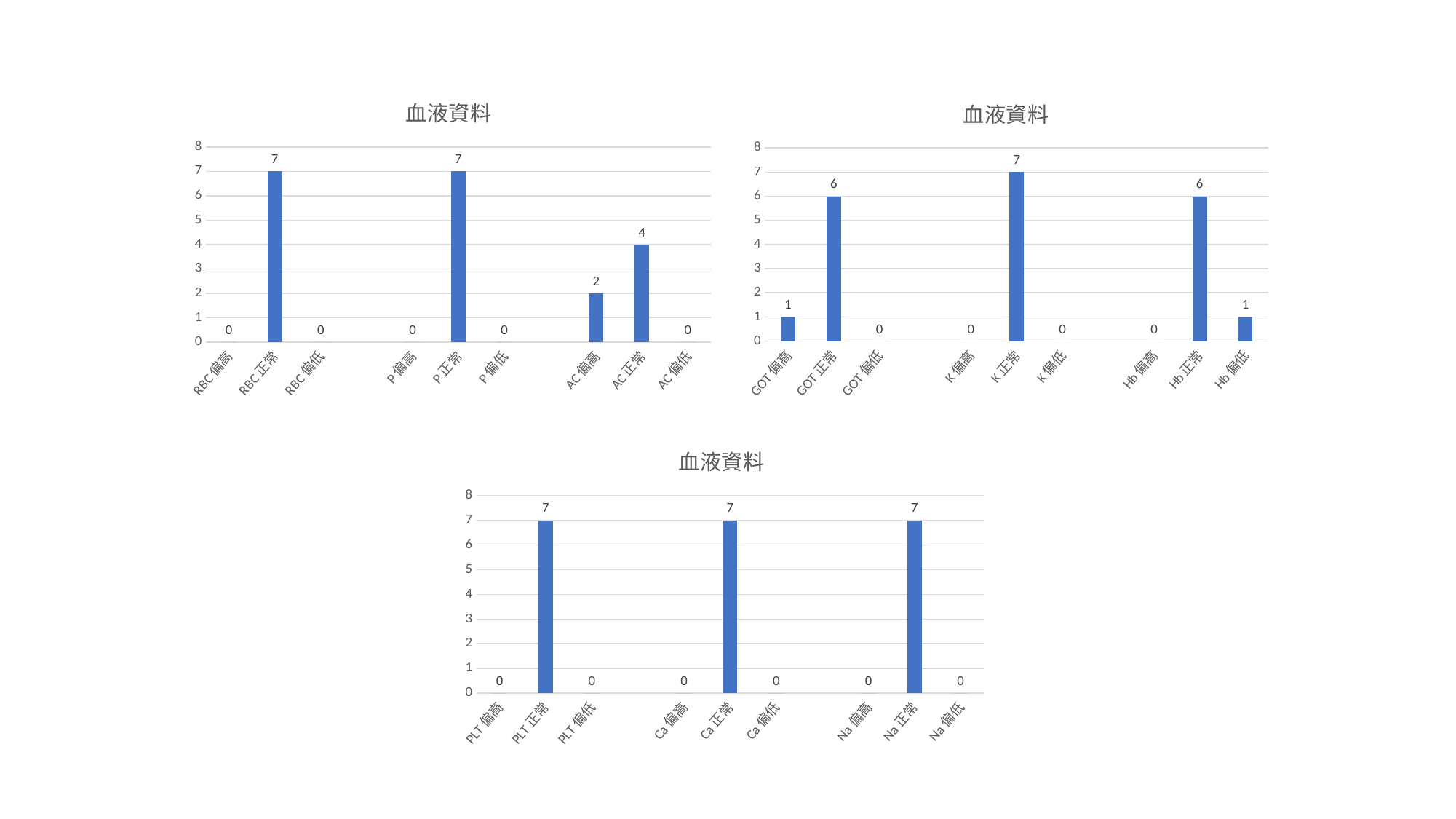
What is the title of the bottom chart? 血液資料 How many categories are shown on the x axis of the bottom chart? 9 In the top-right chart, what is the difference between the values for K 正常 and Hb 正常? 1 In the top-right chart, which is larger, the value for GOT 偏高 or the value for GOT 正常? GOT 正常 In the bottom chart, what is the value for Na 正常? 7 In the top-right chart, what is the value for Hb 偏低? 1 What type of chart is the bottom chart? Bar chart In the top-left chart, what is the value for AC 正常? 4 In the top-left chart, what is the difference between the values for AC 正常 and AC 偏高? 2 In the top-right chart, what is the value for GOT 正常? 6 In the top-left chart, what is the value for AC 偏高? 2 In the top-right chart, which category has the highest value? K 正常